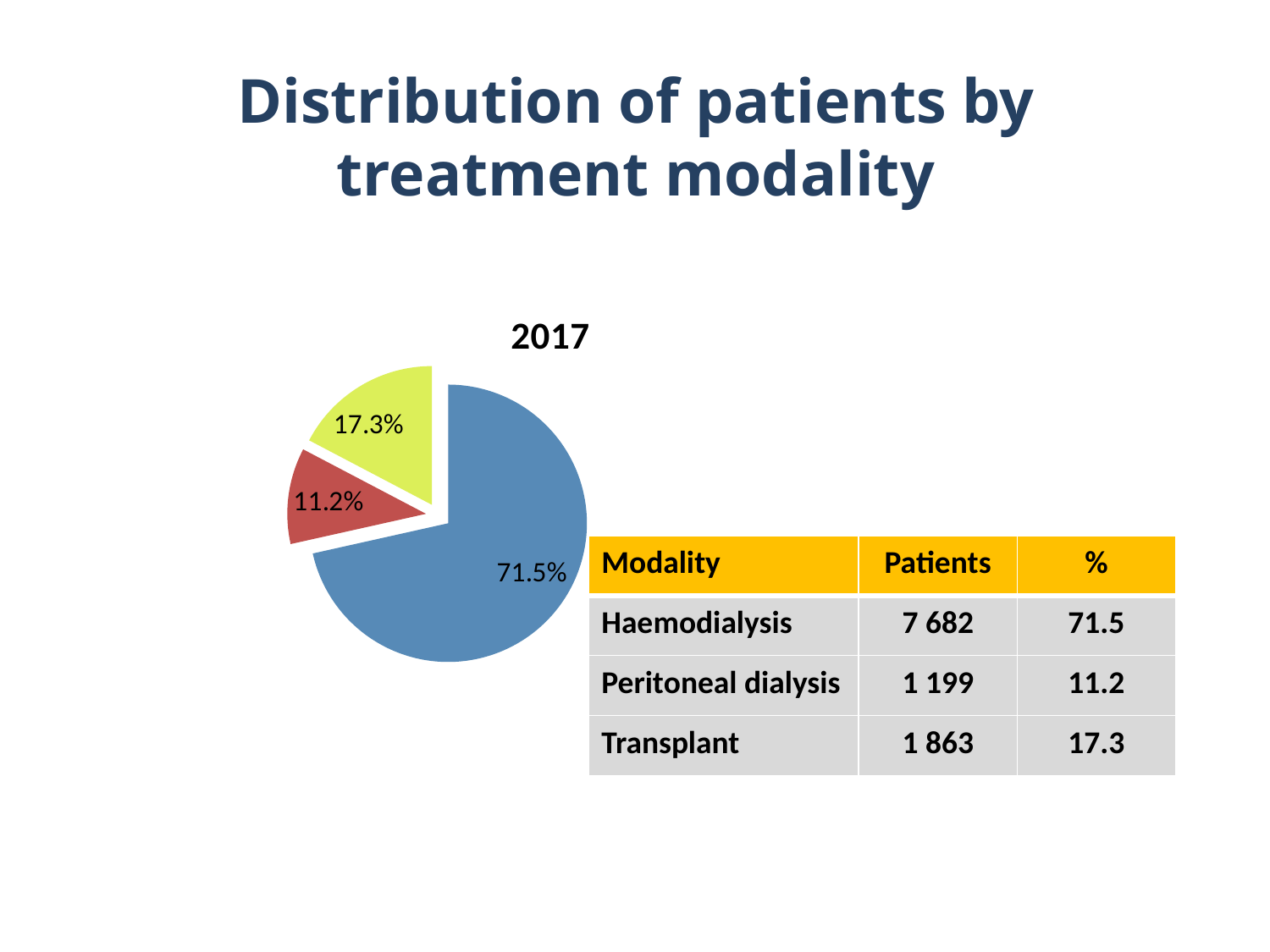
How many slices does the pie chart have? 3 What share does the yellow-green slice of the pie chart represent? 17.3% What share does the red slice of the pie chart represent? 11.2% What kind of chart is shown on the slide? pie chart Which treatment modality corresponds to the smallest slice of the pie chart? Peritoneal dialysis What is the difference in percentage points between the 17.3% slice and the 11.2% slice of the pie chart? 6.1 What is the share of the largest slice of the pie chart? 71.5% Which treatment modality corresponds to the largest slice of the pie chart? Haemodialysis Is the share of the blue slice of the pie chart greater or less than 50%? greater Which slice is larger in the pie chart, the 17.3% slice or the 11.2% slice? 17.3% What is the title of the pie chart? 2017